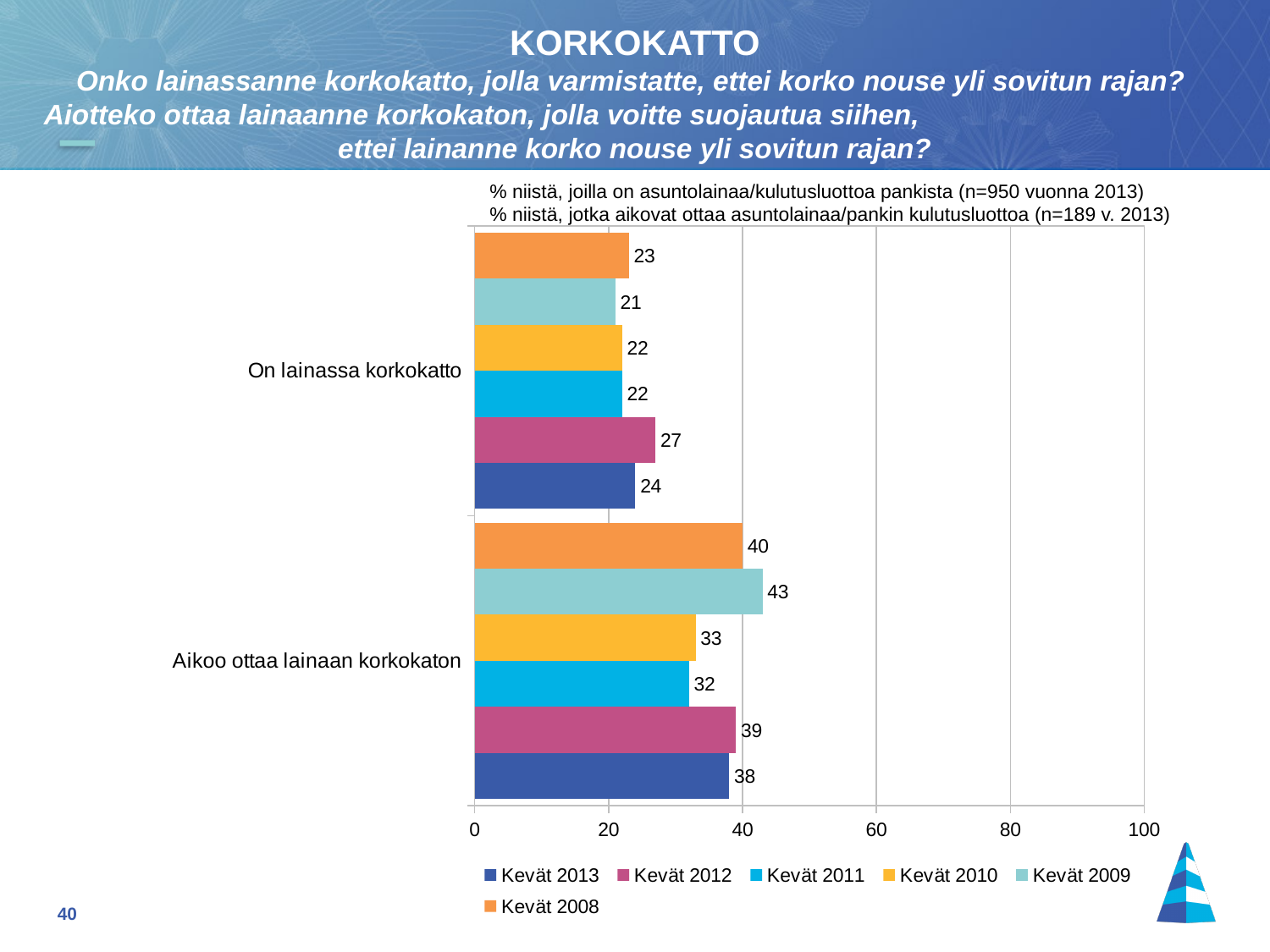
Which series has the lowest value in the category 'Aikoo ottaa lainaan korkokaton'? Kevät 2011 What is the value for Kevät 2009 in the category 'Aikoo ottaa lainaan korkokaton'? 43 Is the value for Kevät 2008 in the category 'Aikoo ottaa lainaan korkokaton' greater or less than 60? less Which series has the highest value in the category 'On lainassa korkokatto'? Kevät 2012 What is the difference between the Kevät 2009 and Kevät 2011 values in the category 'Aikoo ottaa lainaan korkokaton'? 11 What is the maximum value shown on the horizontal axis? 100 What is the value for Kevät 2012 in the category 'Aikoo ottaa lainaan korkokaton'? 39 What kind of chart is shown on the slide? Bar chart What is the value for Kevät 2013 in the category 'On lainassa korkokatto'? 24 How many series does the legend list? 6 Which is larger in the category 'On lainassa korkokatto': the Kevät 2012 value or the Kevät 2008 value? Kevät 2012 How many categories are shown on the chart? 2